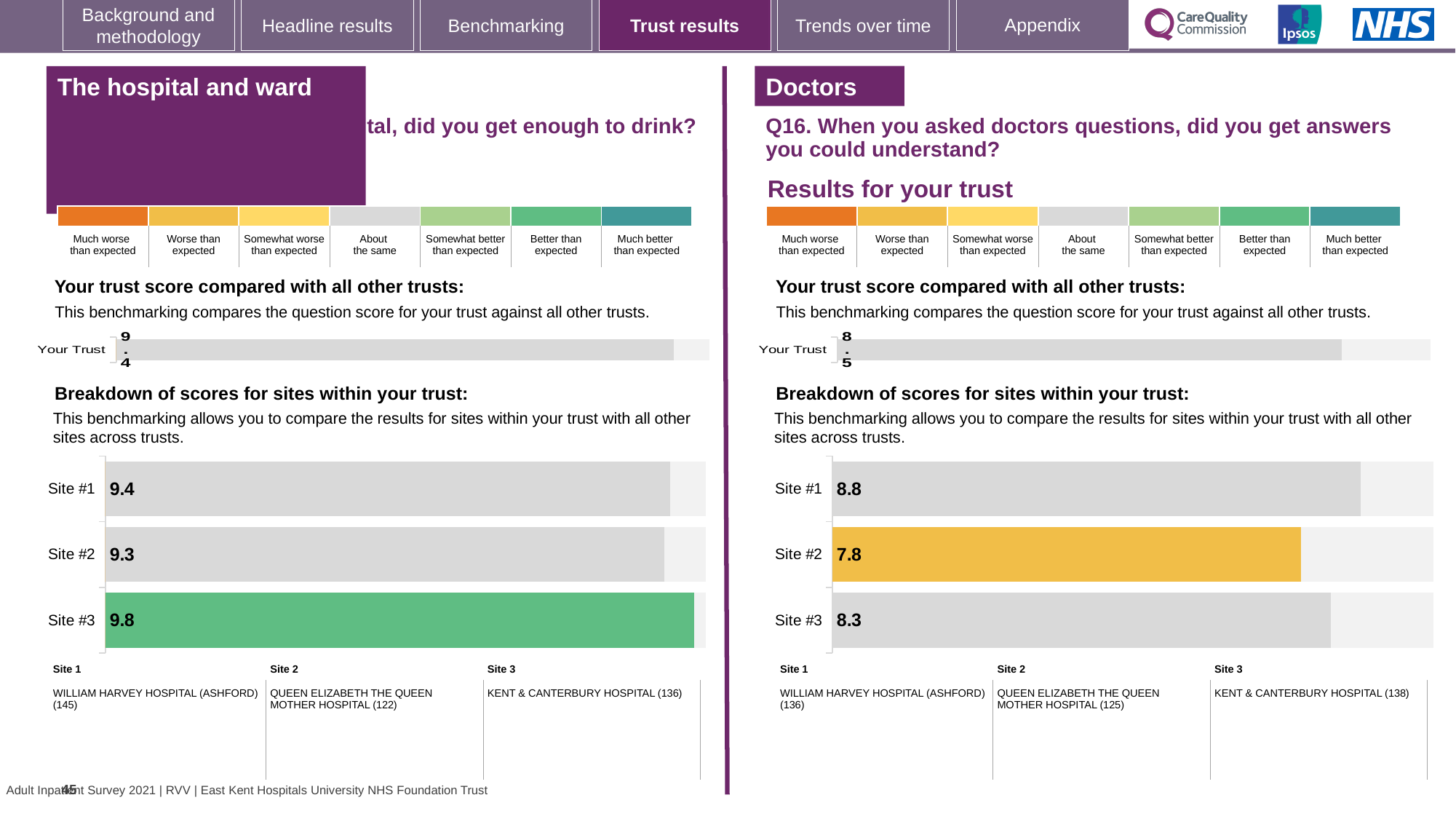
In the 'Your trust score compared with all other trusts' chart on the right-hand (Doctors, Q16) side, what is the score shown for Your Trust? 8.5 In the 'Breakdown of scores for sites within your trust' chart on the right-hand (Doctors, Q16) side, what is the score for Site #2? 7.8 In the site breakdown chart on the left-hand side, what is the difference between the scores for Site #3 and Site #2? 0.5 In the site breakdown chart on the right-hand (Doctors) side of the slide, which site has the lowest score? Site #2 What type of chart is used for the 'Breakdown of scores for sites within your trust' on the right-hand (Doctors) side? Bar chart In the site breakdown chart on the right-hand (Doctors) side, which site's bar is coloured yellow rather than grey? Site #2 In the site breakdown chart on the right-hand (Doctors) side, what is the difference between the scores for Site #1 and Site #2? 1.0 In the 'Your trust score compared with all other trusts' chart on the left-hand side, what is the score shown for Your Trust? 9.4 How many sites are shown in the site breakdown chart on the left-hand side of the slide? 3 In the site breakdown chart on the right-hand (Doctors) side, which has the higher score, Site #1 or Site #3? Site #1 In the site breakdown chart on the left-hand side of the slide, which site has the highest score? Site #3 In the 'Breakdown of scores for sites within your trust' chart on the left-hand (The hospital and ward) side, what is the score for Site #3? 9.8